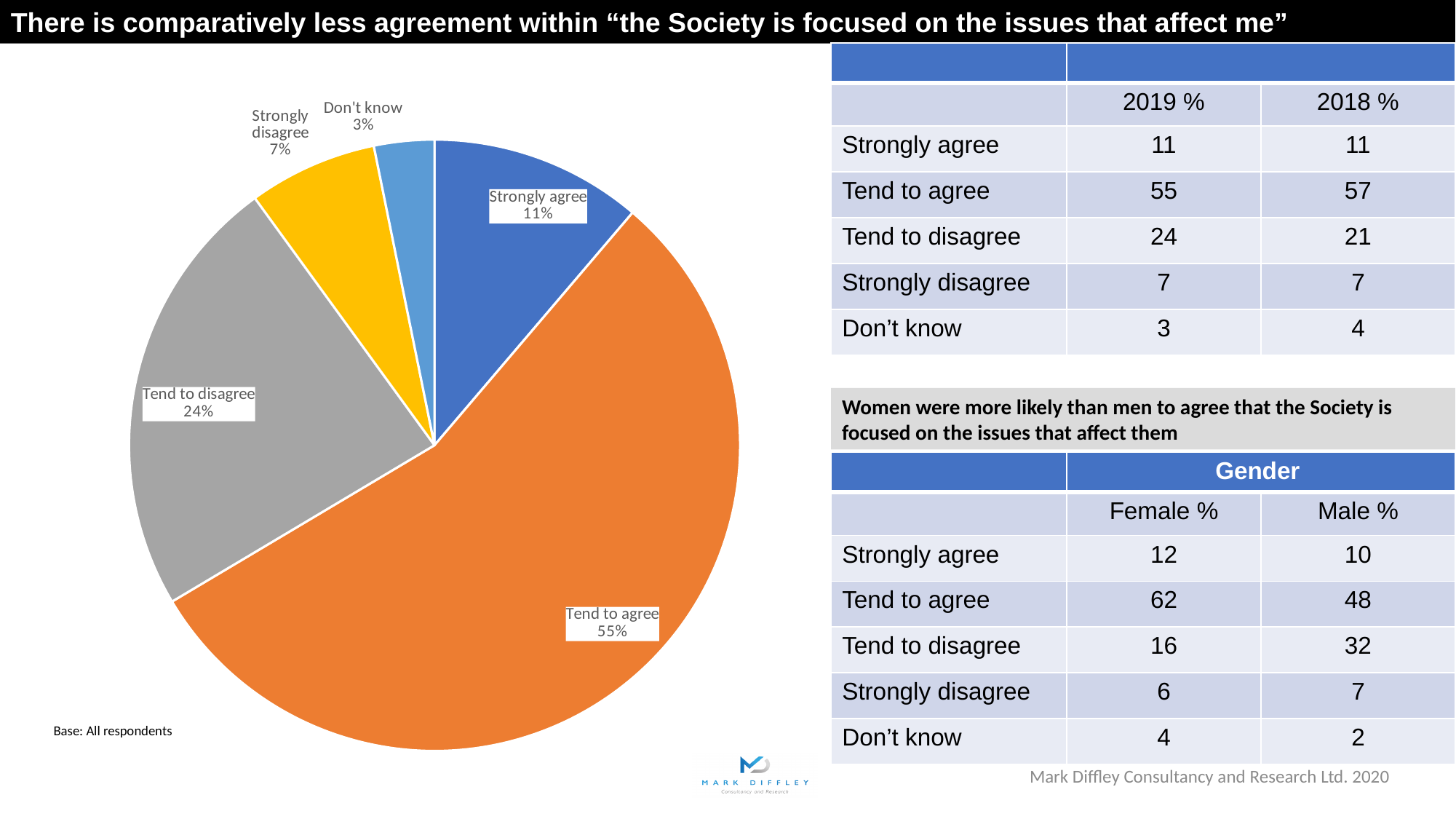
What percentage of respondents 'Tend to agree' in the pie chart? 55% What percentage of respondents answered 'Don't know' in the pie chart? 3% What colour is the 'Tend to agree' slice in the pie chart? orange Which is larger in the pie chart: 'Strongly disagree' or 'Strongly agree'? Strongly agree What is the difference in percentage points between 'Tend to agree' and 'Tend to disagree' in the pie chart? 31 What is the combined share of 'Strongly agree' and 'Tend to agree' in the pie chart? 66% What percentage of respondents 'Tend to disagree' in the pie chart? 24% What percentage of respondents 'Strongly agree' in the pie chart? 11% How many categories are shown in the pie chart? 5 Which category has the largest slice in the pie chart? Tend to agree Which category has the smallest slice in the pie chart? Don't know What kind of chart is shown on the slide? pie chart